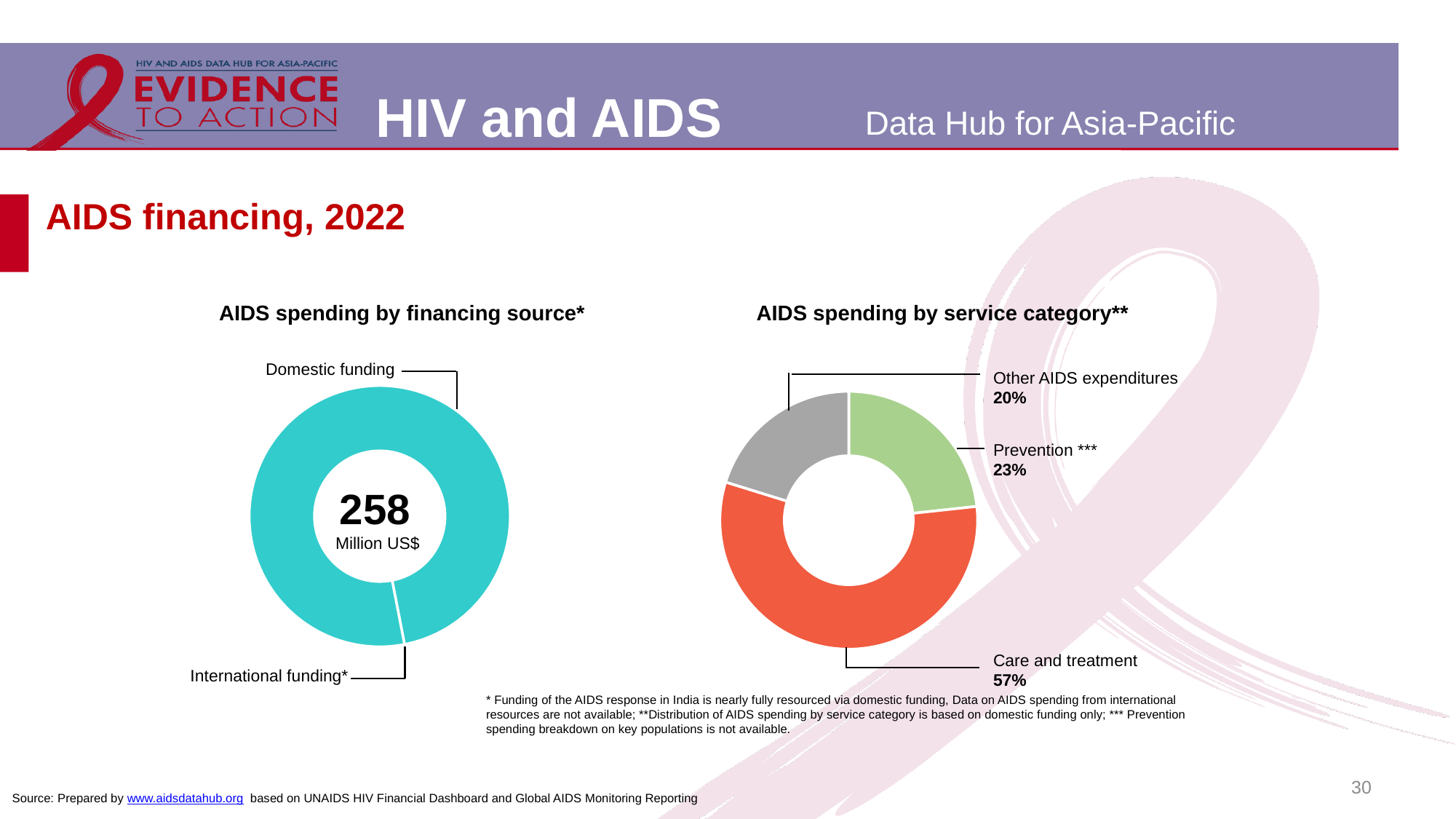
What total value is shown in the centre of the 'AIDS spending by financing source*' chart? 258 Million US$ In the 'AIDS spending by service category**' chart, what share of spending goes to Other AIDS expenditures? 20% How many service categories are shown in the 'AIDS spending by service category**' chart? 3 In the 'AIDS spending by service category**' chart, which service category has the smallest share? Other AIDS expenditures In the 'AIDS spending by service category**' chart, which is larger: Prevention or Other AIDS expenditures? Prevention How many financing sources are shown in the 'AIDS spending by financing source*' chart? 2 In the 'AIDS spending by financing source*' chart, which financing source accounts for the larger share: Domestic funding or International funding? Domestic funding In the 'AIDS spending by service category**' chart, what share of spending goes to Care and treatment? 57% In the 'AIDS spending by service category**' chart, which service category has the largest share? Care and treatment In the 'AIDS spending by service category**' chart, what share of spending goes to Prevention? 23% What kind of chart is the 'AIDS spending by financing source*' chart? Donut (pie) chart In the 'AIDS spending by service category**' chart, what is the difference in percentage points between Care and treatment and Prevention? 34 percentage points